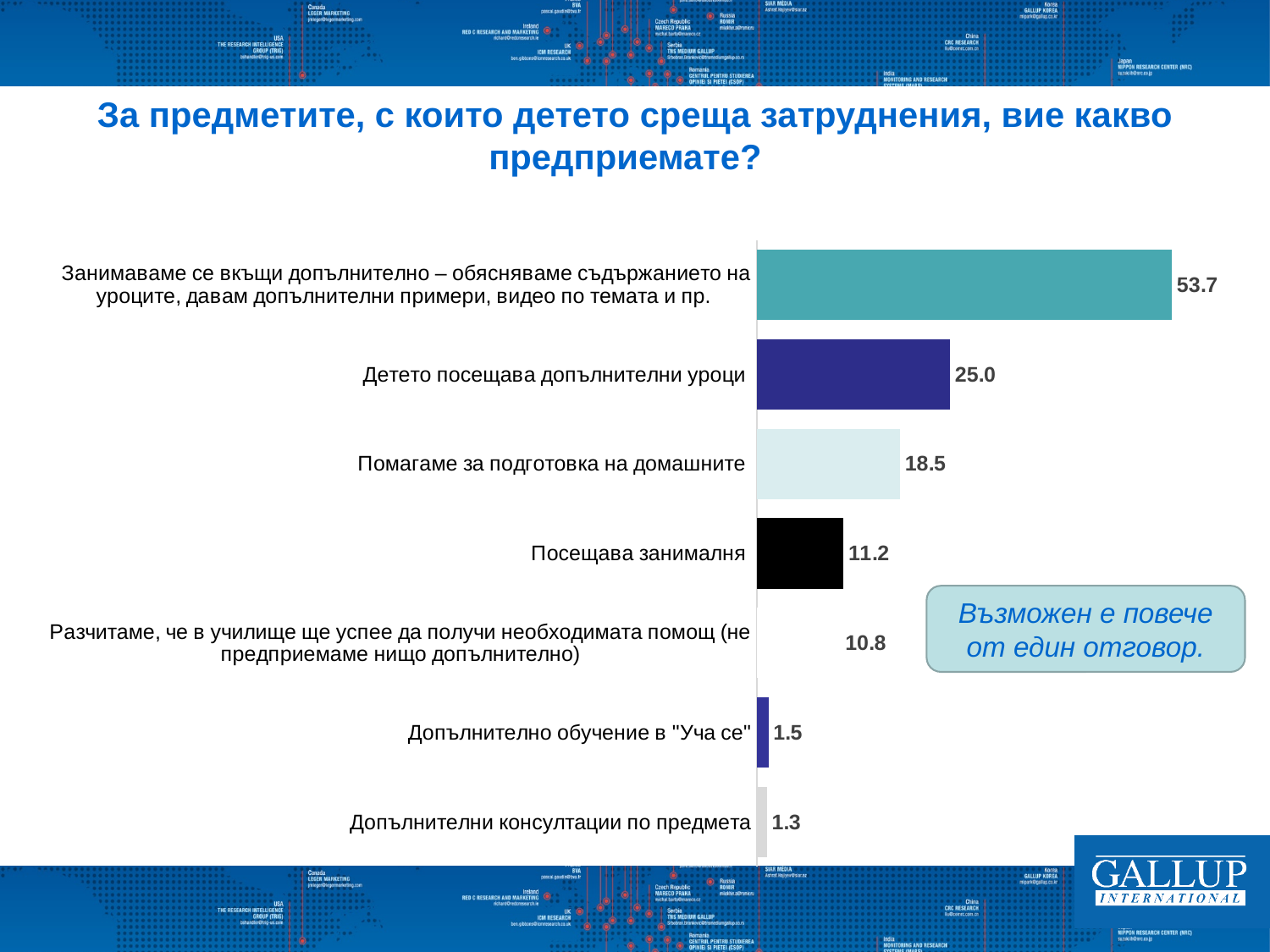
What value is shown for "Посещава занималня"? 11.2 Which category has the lowest value? Допълнителни консултации по предмета What value is shown for "Детето посещава допълнителни уроци"? 25.0 Which is larger: the value for "Посещава занималня" or the value for "Разчитаме, че в училище ще успее да получи необходимата помощ"? Посещава занималня What is the difference between the values for "Детето посещава допълнителни уроци" and "Помагаме за подготовка на домашните"? 6.5 What value is shown for "Помагаме за подготовка на домашните"? 18.5 What kind of chart is shown on the slide? Bar chart How many categories are shown in the chart? 7 What is the title of the slide? За предметите, с които детето среща затруднения, вие какво предприемате? What value is shown for "Допълнителни консултации по предмета"? 1.3 Which category has the highest value? Занимаваме се вкъщи допълнително – обясняваме съдържанието на уроците, давам допълнителни примери, видео по темата и пр. What does the note box on the chart say? Възможен е повече от един отговор.